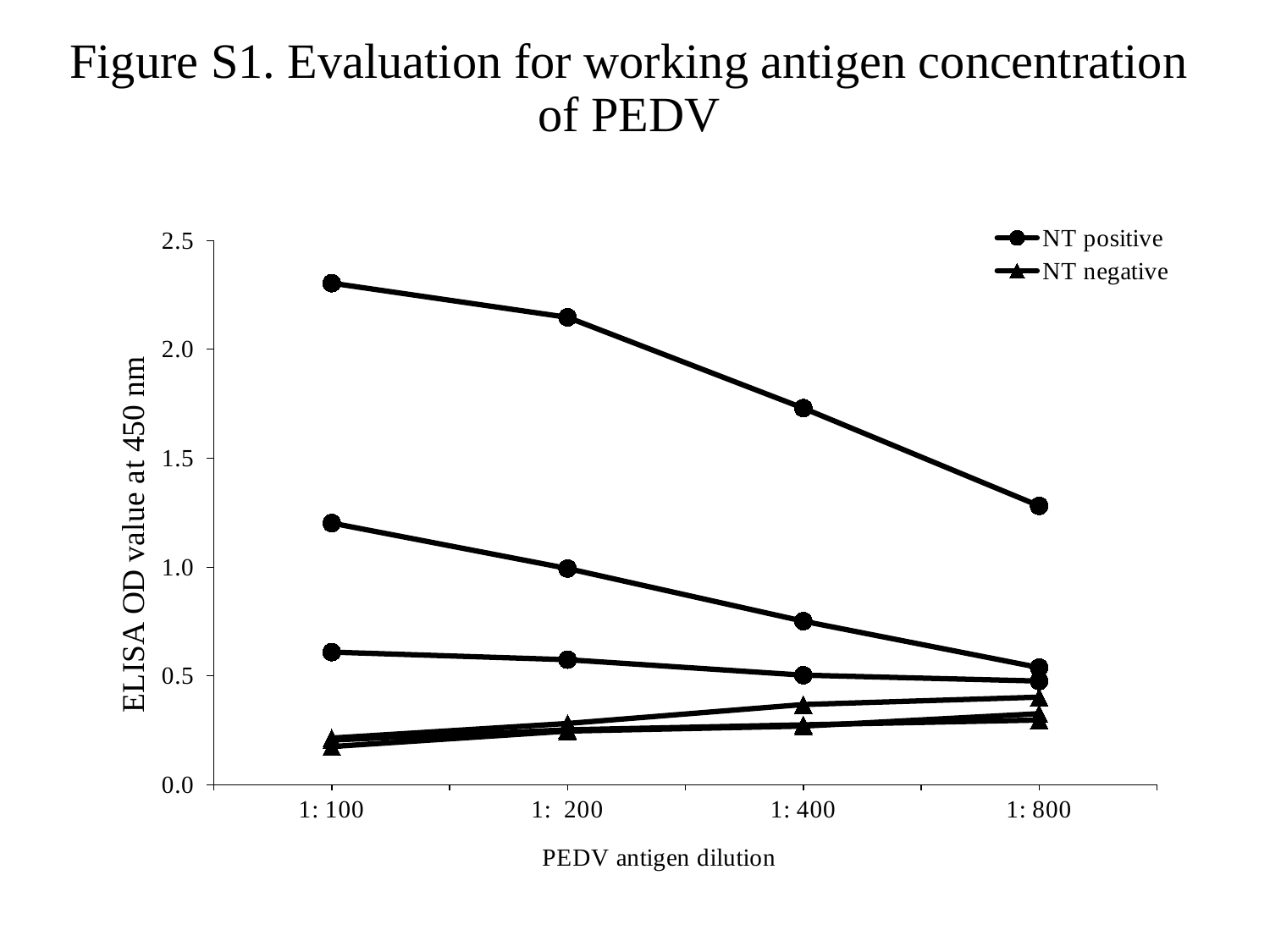
At which antigen dilution does the topmost NT positive line reach its highest value? 1:100 How many PEDV antigen dilutions are shown on the x axis? 4 At 1:100, which series has the larger values, NT positive or NT negative? NT positive Is the value of the topmost NT positive line at 1:100 greater or less than 2.0? greater What is the label of the x axis? PEDV antigen dilution What kind of chart is shown on the slide? line chart What is the label of the y axis? ELISA OD value at 450 nm Is the value of the topmost NT positive line at 1:400 greater or less than 1.5? greater Are the NT negative values at 1:100 greater or less than 0.5? less How many series does the legend list? 2 Does the topmost NT positive line rise or fall as the antigen dilution goes from 1:100 to 1:800? fall